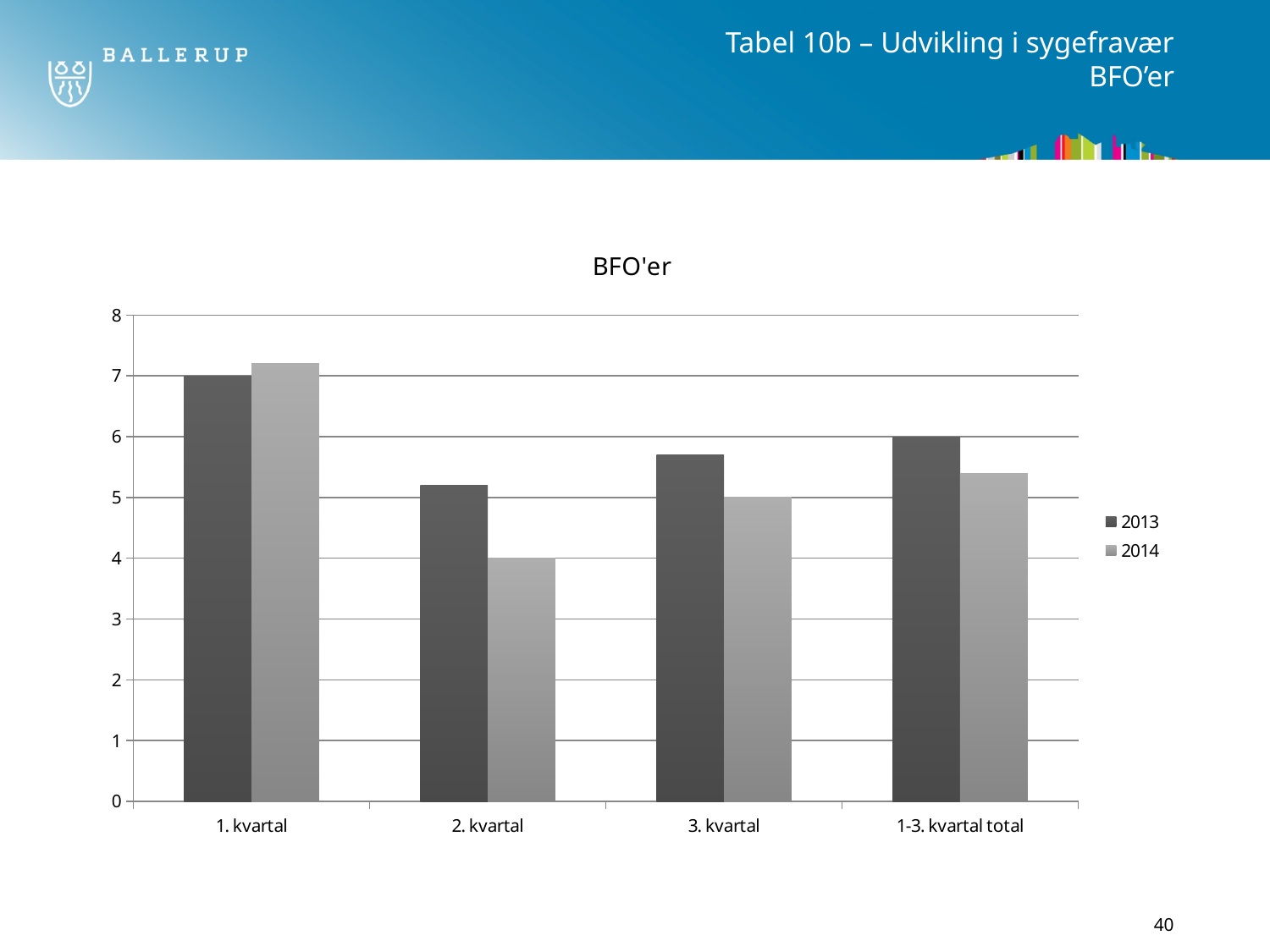
What is the value for 2013 in 1. kvartal? 7 What is the value for 2014 in 3. kvartal? 5 What is the value for 2014 in 2. kvartal? 4 How many categories are shown on the x axis? 4 How many series does the legend list? 2 Is the value for 2013 in 3. kvartal greater or less than 6? less In 2. kvartal, which series has the larger value, 2013 or 2014? 2013 Which category has the lowest value for 2014? 2. kvartal Is the value for 2014 in 1. kvartal greater or less than 7? greater What is the difference between the 2013 value in 1. kvartal and the 2013 value in 1-3. kvartal total? 1 What type of chart is shown on the slide? bar chart What is the value for 2013 in 1-3. kvartal total? 6